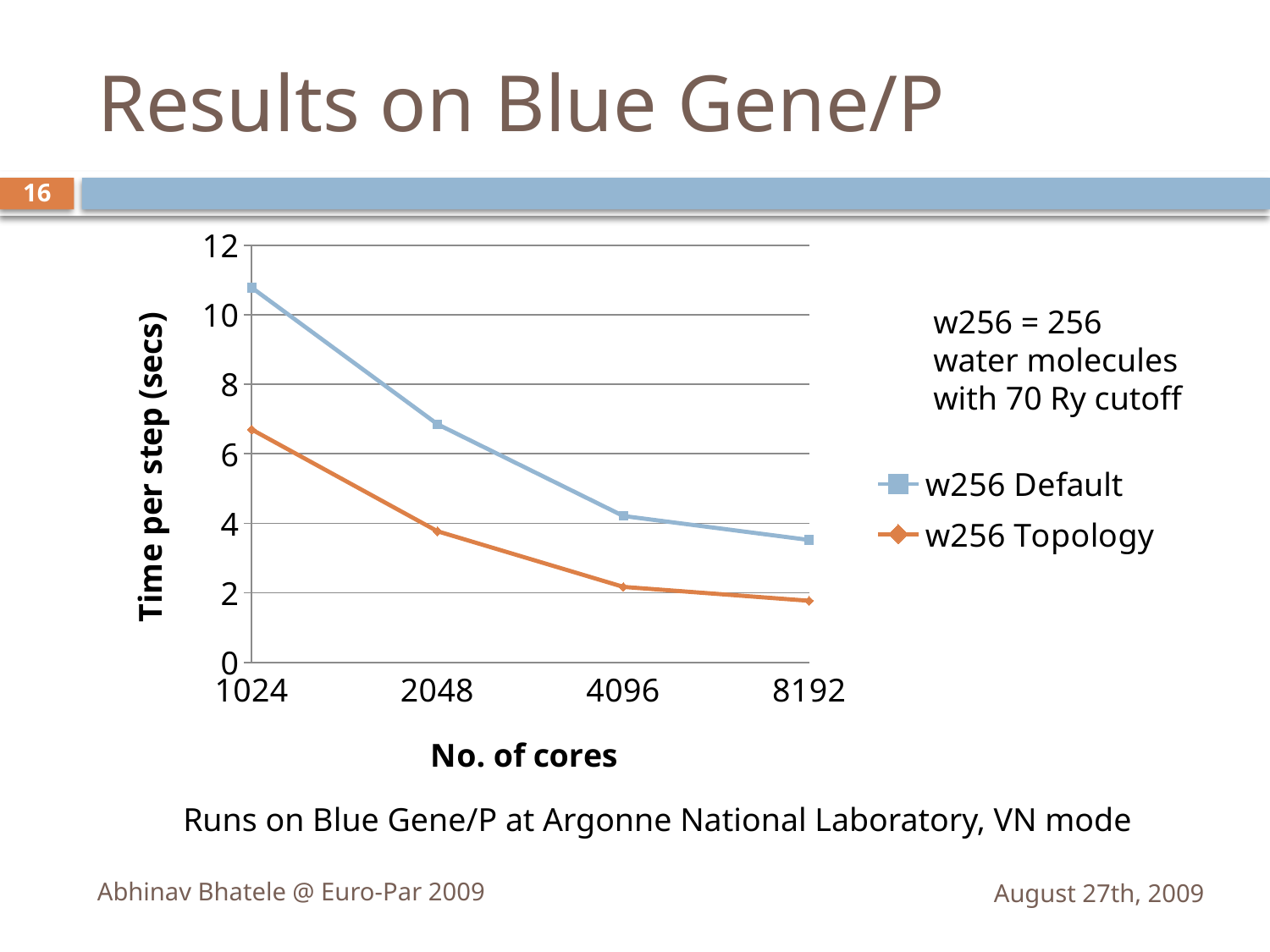
Is the time per step for w256 Default at 1024 cores greater or less than 10? greater At 4096 cores, which series has the higher time per step, w256 Default or w256 Topology? w256 Default Does the time per step for w256 Topology rise or fall as the number of cores increases? fall Is the time per step for w256 Topology at 2048 cores greater or less than 6? less How many series does the legend list? 2 Is the time per step for w256 Topology at 1024 cores greater or less than 6? greater Does the time per step for w256 Default rise or fall as the number of cores increases? fall What is the label of the y axis? Time per step (secs) What kind of chart is shown on the slide? line chart How many core counts are plotted along the x axis? 4 What is the label of the x axis? No. of cores